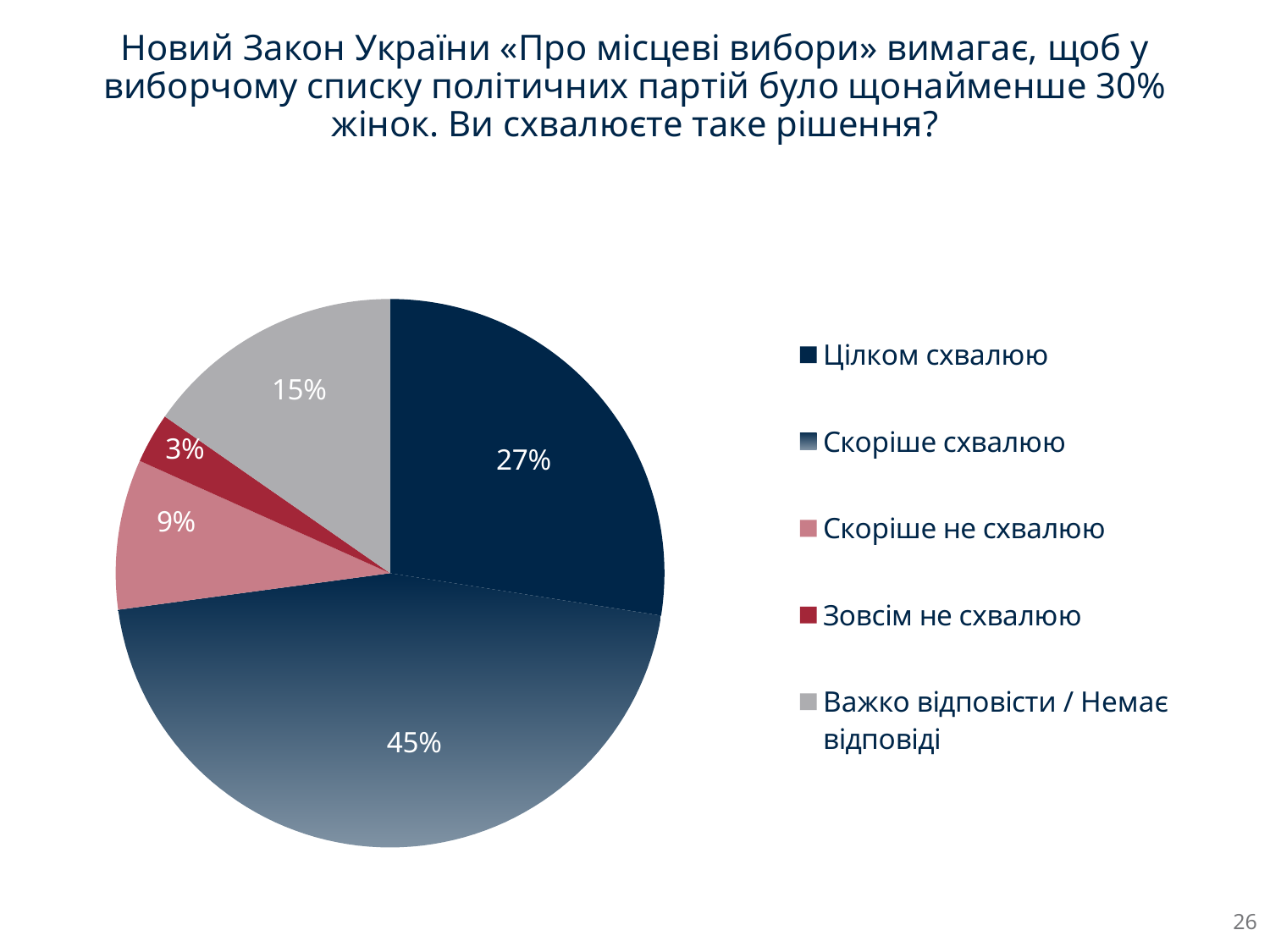
Which category has the smallest slice of the pie? Зовсім не схвалюю What colour is the slice for "Зовсім не схвалюю"? Dark red How many categories does the legend list? 5 What share of the pie is labelled "Важко відповісти / Немає відповіді"? 15% What share of the pie is labelled "Скоріше не схвалюю"? 9% What share of the pie is labelled "Цілком схвалюю"? 27% What share of the pie is labelled "Зовсім не схвалюю"? 3% What is the difference in percentage points between "Скоріше схвалюю" and "Цілком схвалюю"? 18 What kind of chart is shown on the slide? Pie chart Which category has the largest slice of the pie? Скоріше схвалюю What share of the pie is labelled "Скоріше схвалюю"? 45% Which is larger: the slice for "Важко відповісти / Немає відповіді" or the slice for "Скоріше не схвалюю"? Важко відповісти / Немає відповіді